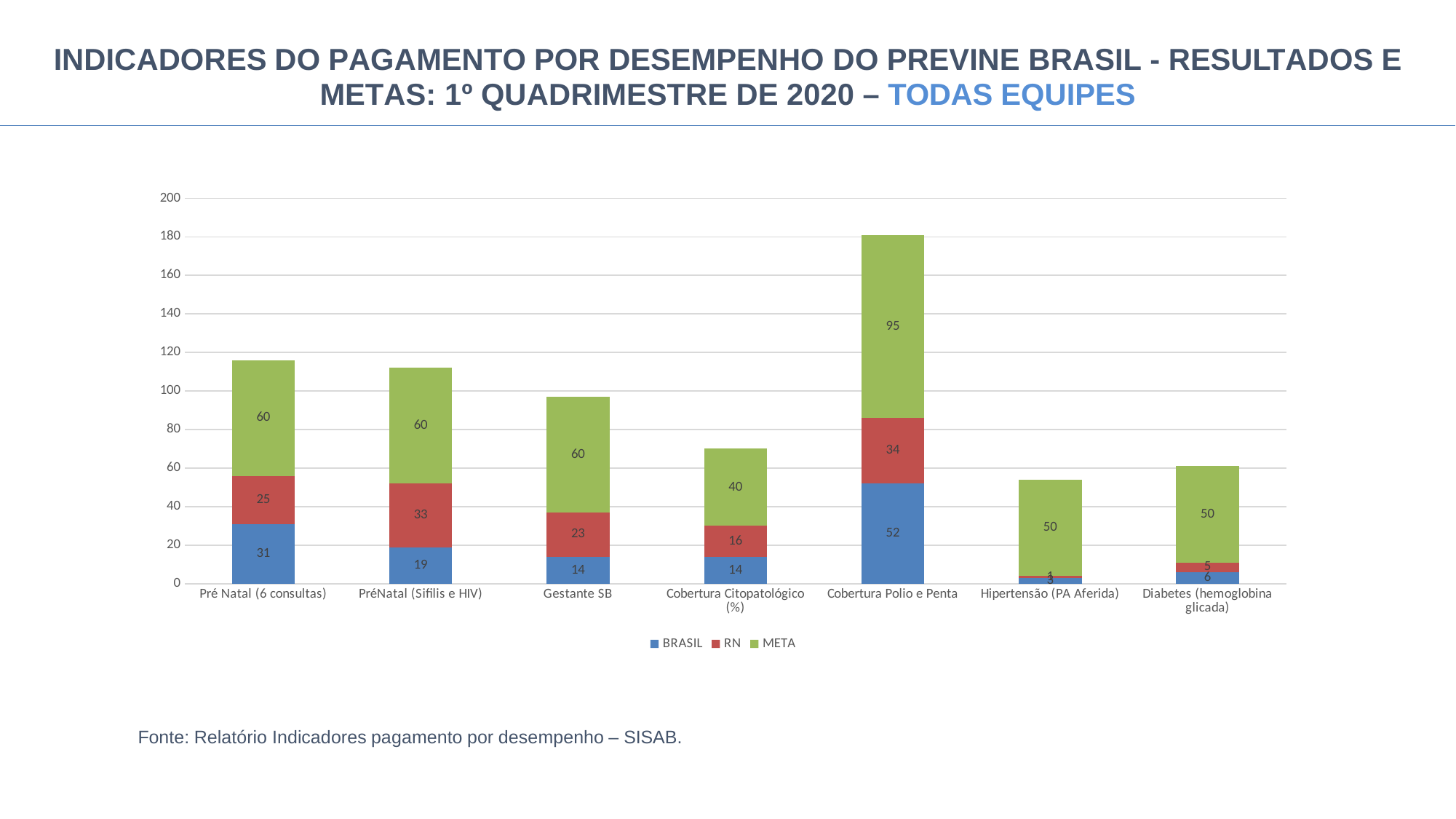
What is the total of the stacked bar for Gestante SB? 97 Which is larger, the BRASIL value for Pré Natal (6 consultas) or the BRASIL value for PréNatal (Sifilis e HIV)? Pré Natal (6 consultas) Which category has the lowest META value among those with a META of 60 or less, excluding ties — which category has the lowest META value overall? Cobertura Citopatológico (%) What is the BRASIL value for Cobertura Polio e Penta? 52 What is the META value for Cobertura Citopatológico (%)? 40 How many series does the legend list? 3 How many categories are shown on the x axis? 7 What is the RN value for PréNatal (Sifilis e HIV)? 33 Which category has the highest BRASIL value? Cobertura Polio e Penta Which series is shown in green in the legend? META What type of chart is shown on the slide? stacked bar chart What is the difference between the RN values for Cobertura Polio e Penta and Gestante SB? 11